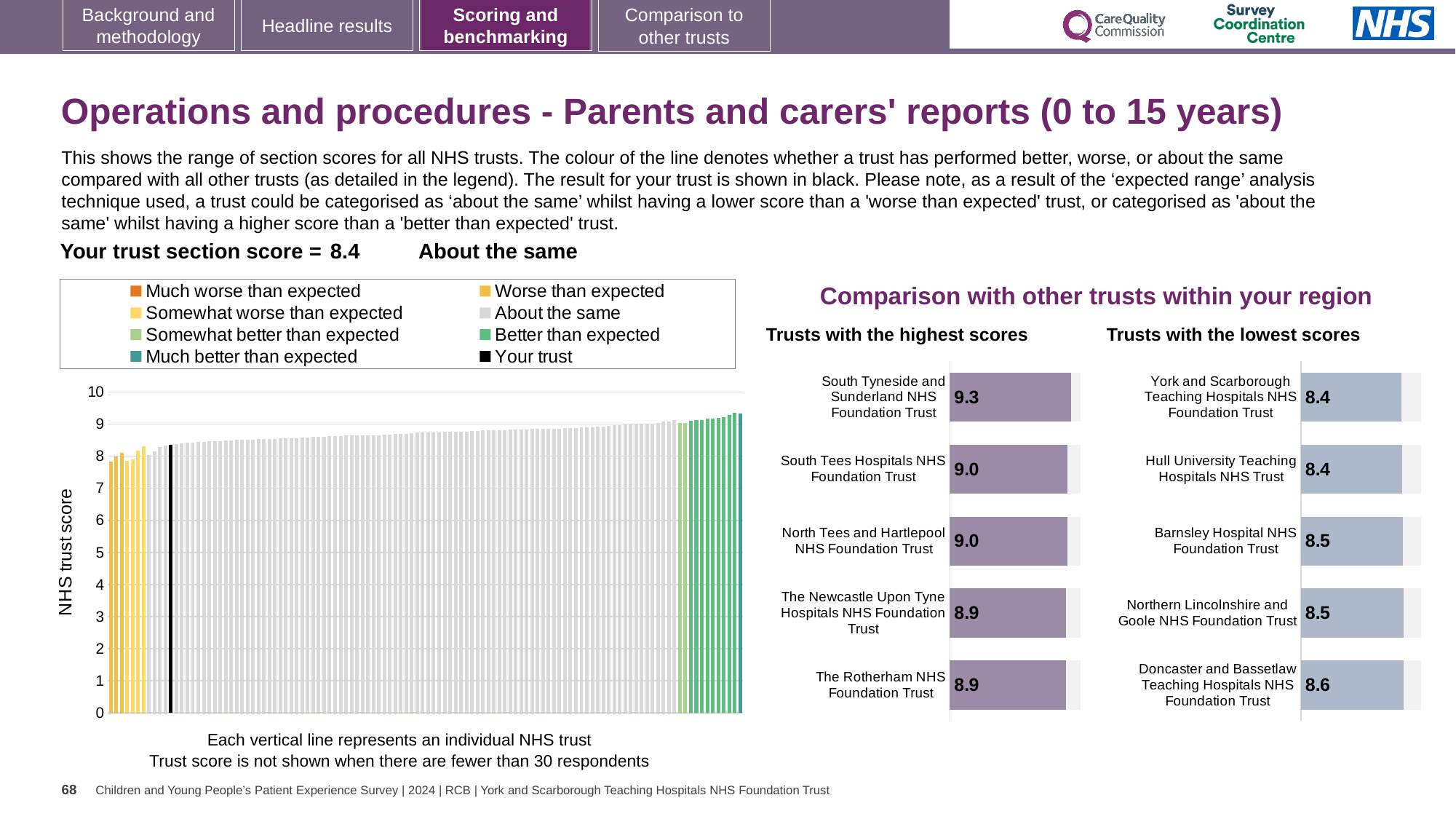
In the 'Trusts with the lowest scores' chart, what is the score for Doncaster and Bassetlaw Teaching Hospitals NHS Foundation Trust? 8.6 In the 'Trusts with the highest scores' chart, which trust has the highest score? South Tyneside and Sunderland NHS Foundation Trust In the left-hand chart of NHS trust scores, what is the section score for your trust? 8.4 In the 'Trusts with the lowest scores' chart, what is the score for Barnsley Hospital NHS Foundation Trust? 8.5 In the 'Trusts with the highest scores' chart, what is the difference between the scores of South Tyneside and Sunderland NHS Foundation Trust and The Rotherham NHS Foundation Trust? 0.4 In the 'Trusts with the highest scores' chart, what is the score for South Tyneside and Sunderland NHS Foundation Trust? 9.3 How many entries does the legend of the left-hand NHS trust score chart list? 8 In the 'Trusts with the highest scores' chart, how many trusts are shown? 5 In the 'Trusts with the lowest scores' chart, which trust has the highest score? Doncaster and Bassetlaw Teaching Hospitals NHS Foundation Trust Which is larger: the score for South Tees Hospitals NHS Foundation Trust in the highest scores chart or the score for Northern Lincolnshire and Goole NHS Foundation Trust in the lowest scores chart? South Tees Hospitals NHS Foundation Trust In the 'Trusts with the lowest scores' chart, what is the difference between the scores of Doncaster and Bassetlaw Teaching Hospitals NHS Foundation Trust and Hull University Teaching Hospitals NHS Trust? 0.2 What kind of chart is the left-hand chart showing NHS trust scores? Bar chart